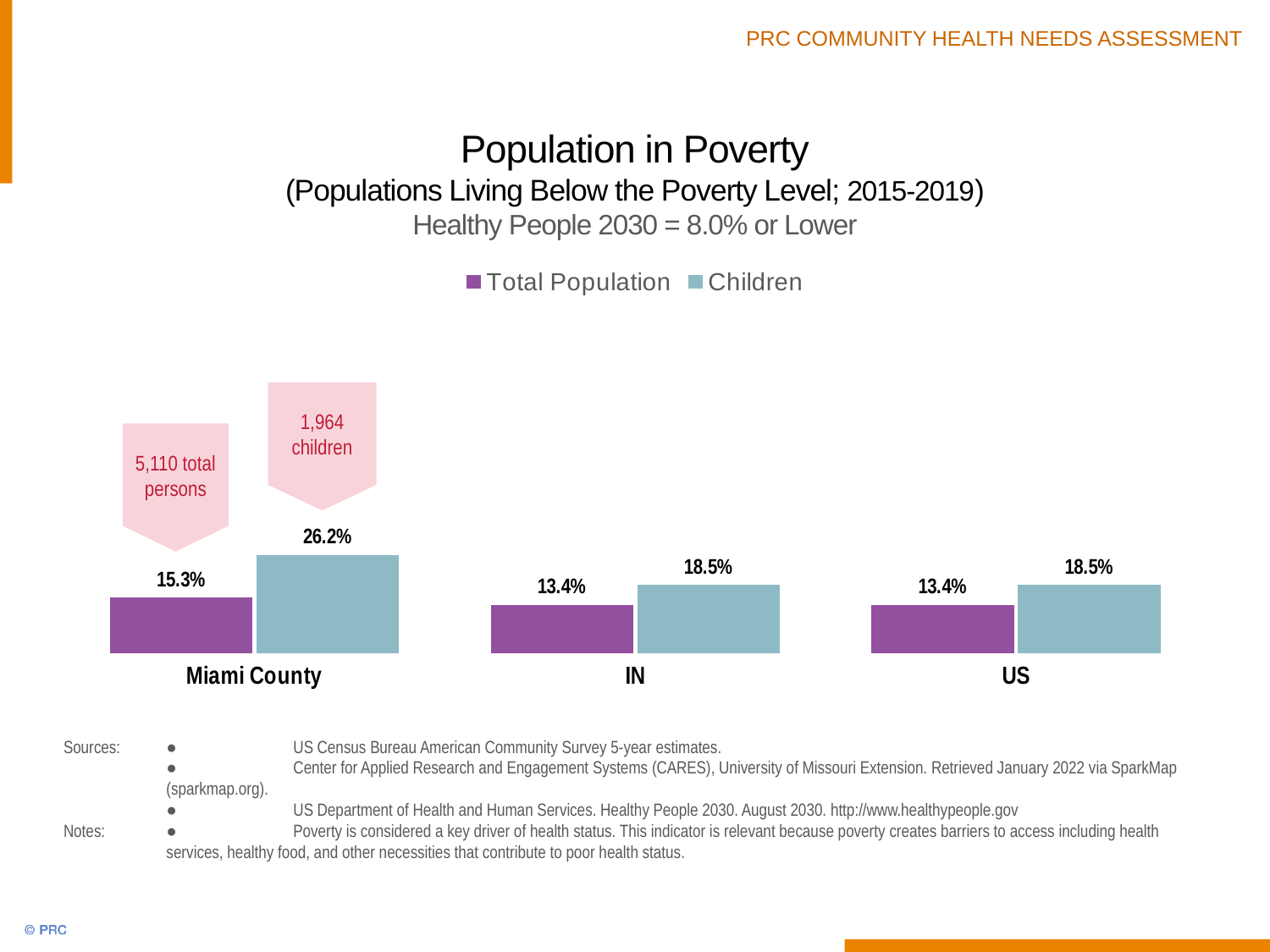
What kind of chart is shown on the slide? Bar chart According to the callout, how many children in Miami County are living in poverty? 1,964 How many series does the legend list? 2 What is the difference between the Miami County and IN Total Population values? 1.9% Which is larger, the Children value for Miami County or the Children value for US? Miami County What is the Children value for Miami County? 26.2% What is the Total Population value for Miami County? 15.3% Which category has the highest Children value? Miami County What is the Children value for IN? 18.5% What is the Total Population value for US? 13.4% How many categories are shown on the x axis? 3 What is the difference between the Children and Total Population values for Miami County? 10.9%